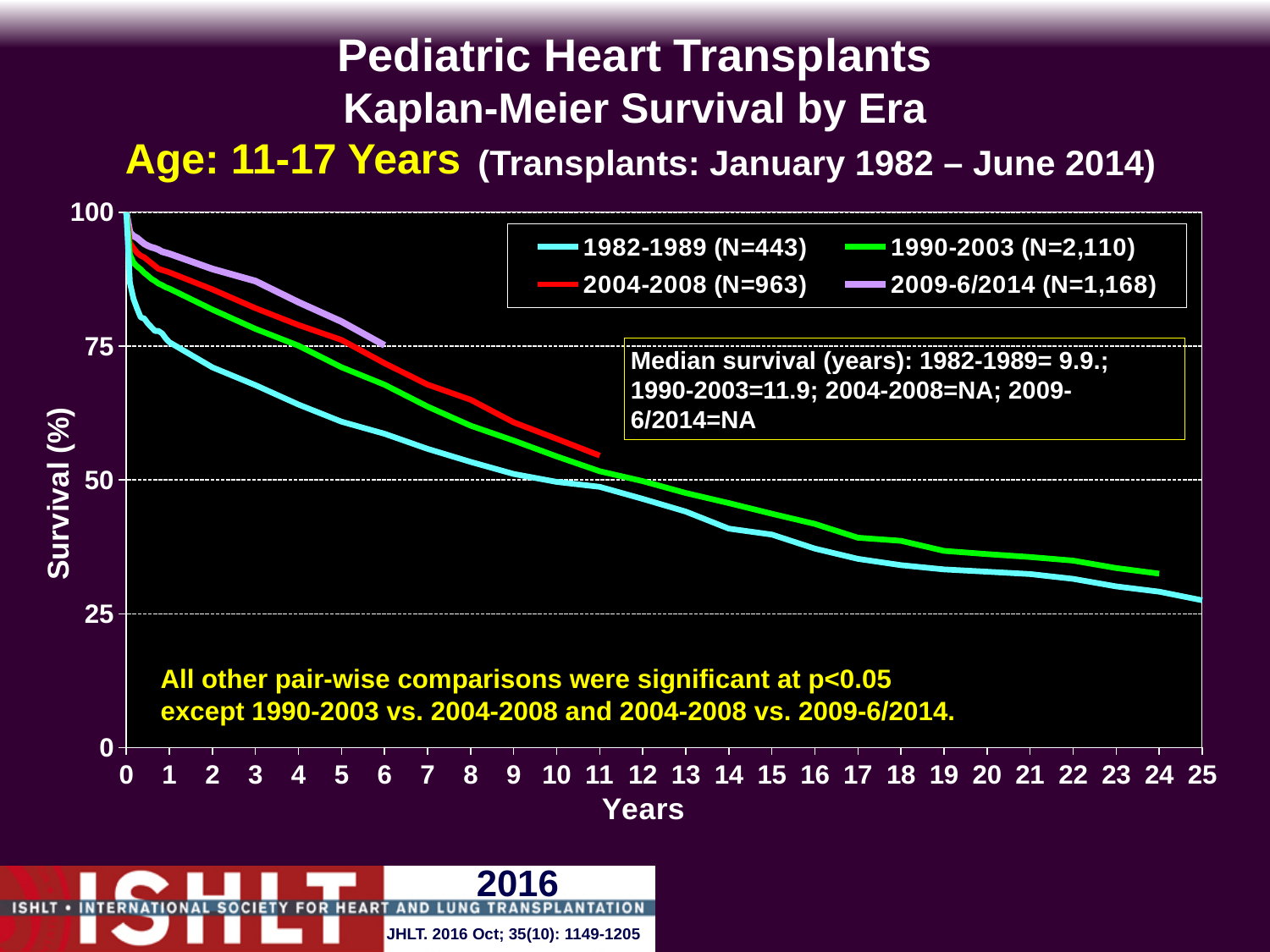
Is the survival for the 1990-2003 series at 24 years greater or less than 25? greater What is the median survival for the 2004-2008 era? NA What is the median survival in years for the 1982-1989 era? 9.9 Is the survival for the 1982-1989 series at 5 years greater or less than 50? greater Do the survival curves rise or fall as years increase? fall Is the survival for the 2009-6/2014 series at 3 years greater or less than 75? greater How many series does the legend list? 4 Which series has the highest survival at 3 years? 2009-6/2014 At 5 years, which series has higher survival, 1982-1989 or 1990-2003? 1990-2003 What kind of chart is shown on the slide? line chart Which series has the lowest survival at 10 years? 1982-1989 What is the median survival in years for the 1990-2003 era? 11.9